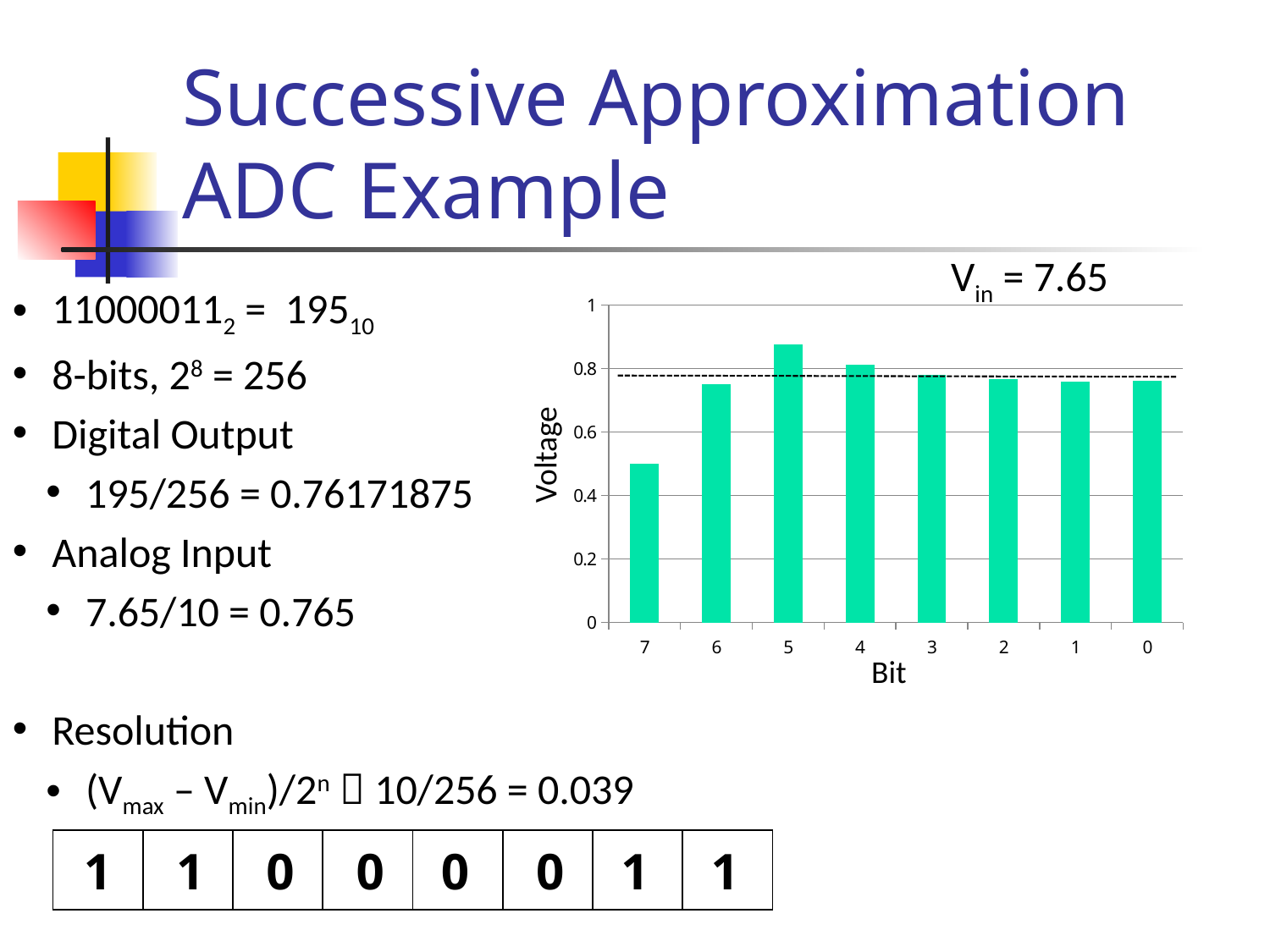
What kind of chart is shown on the slide? bar chart Which has the larger voltage bar, bit 5 or bit 7? bit 5 How many bits (categories) are plotted on the x axis of the chart? 8 Which has the larger voltage bar, bit 7 or bit 6? bit 6 Is the voltage for bit 7 greater or less than 0.4? greater Which bit has the lowest voltage bar in the chart? 7 What is the label of the x axis of the chart? Bit What is the label of the y axis of the chart? Voltage Is the voltage for bit 6 greater or less than 0.8? less Which bit has the highest voltage bar in the chart? 5 Is the voltage for bit 5 greater or less than 0.8? greater